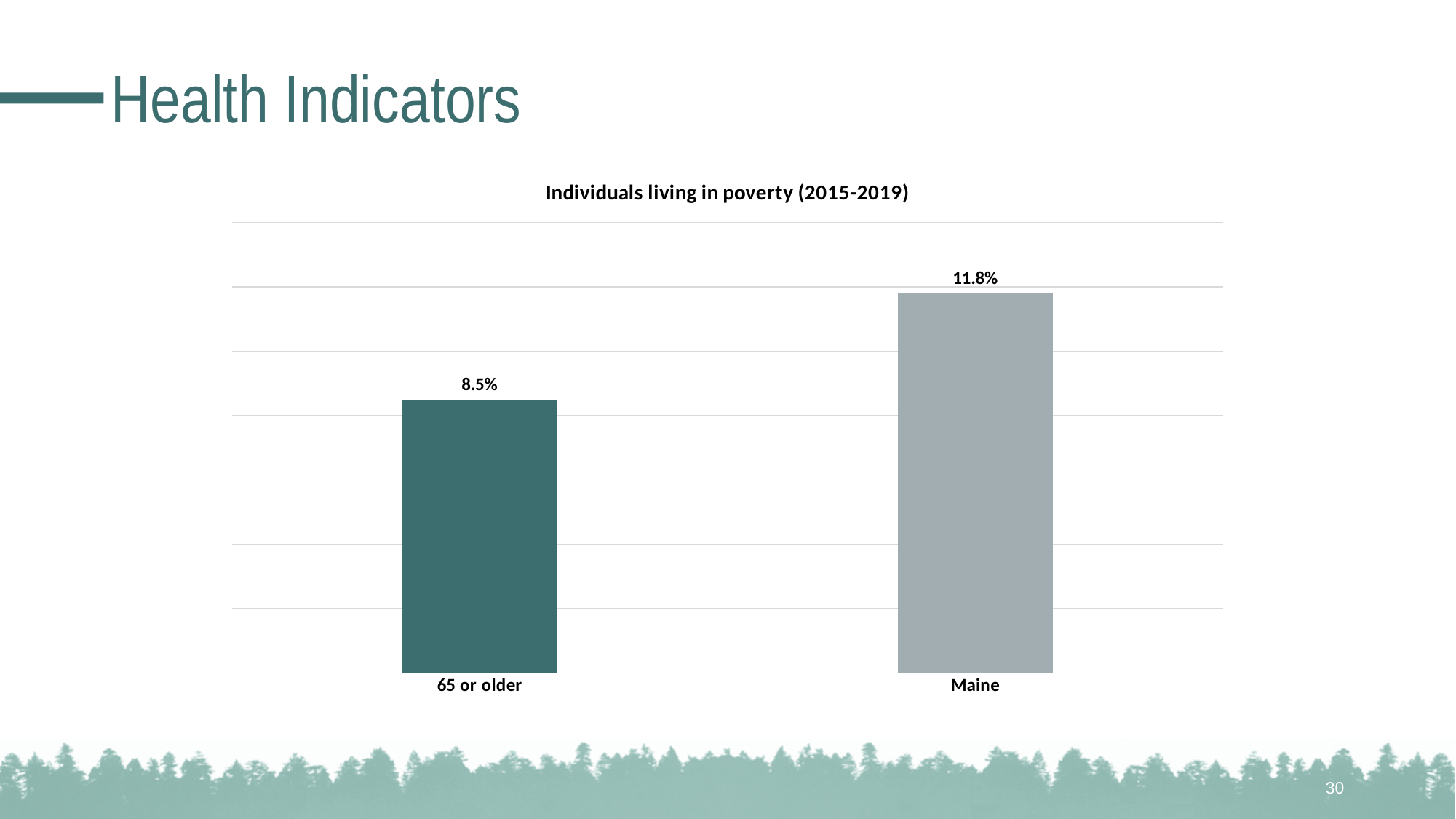
Which category has the lowest value? 65 or older What is the value for Maine? 11.8% What colour is the bar for 65 or older? Dark teal What kind of chart is shown on the slide? Bar chart How many categories are shown in the chart? 2 Which category has the highest value? Maine What is the difference between the value for Maine and the value for 65 or older? 3.3% Which is larger, the value for 65 or older or the value for Maine? Maine What is the value for 65 or older? 8.5% What is the title of the chart? Individuals living in poverty (2015-2019)